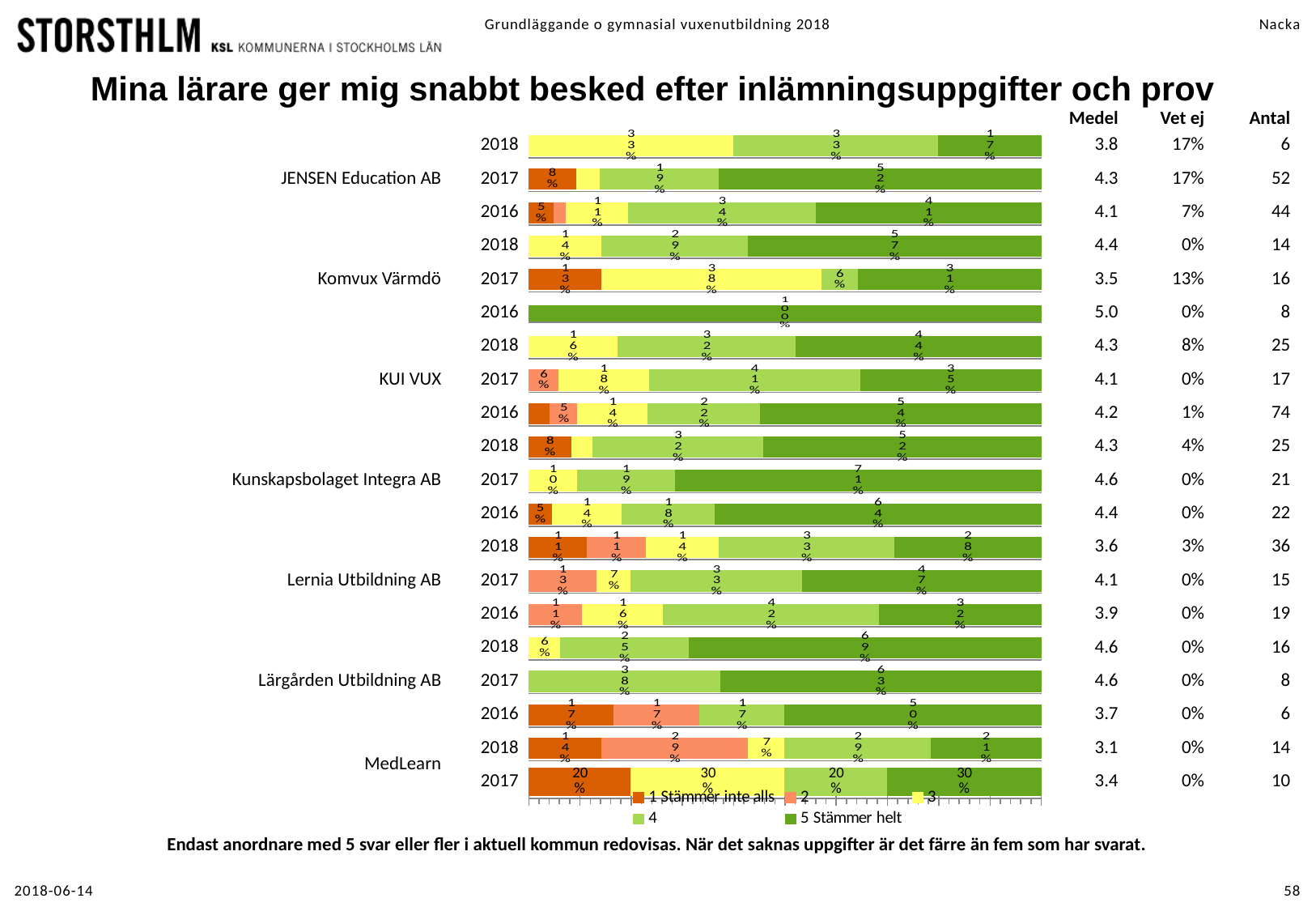
What share of MedLearn respondents in 2017 answered '5 Stämmer helt'? 30% What share of MedLearn respondents in 2017 answered '1 Stämmer inte alls'? 20% What share of Komvux Värmdö respondents in 2016 answered '5 Stämmer helt'? 100% For Lärgården Utbildning AB in 2017, what is the difference in percentage points between the '5 Stämmer helt' share and the '4' share? 25 percentage points What share of Lärgården Utbildning AB respondents in 2018 answered '3'? 6% How many education providers are shown in the chart? 7 What share of Lärgården Utbildning AB respondents in 2018 answered '5 Stämmer helt'? 69% What is the title of the chart? Mina lärare ger mig snabbt besked efter inlämningsuppgifter och prov For Lernia Utbildning AB in 2018, which is larger: the share answering '4' or the share answering '5 Stämmer helt'? 4 What kind of chart is shown on the slide? Stacked horizontal bar chart How many series does the chart legend list? 5 What share of Kunskapsbolaget Integra AB respondents in 2017 answered '5 Stämmer helt'? 71%